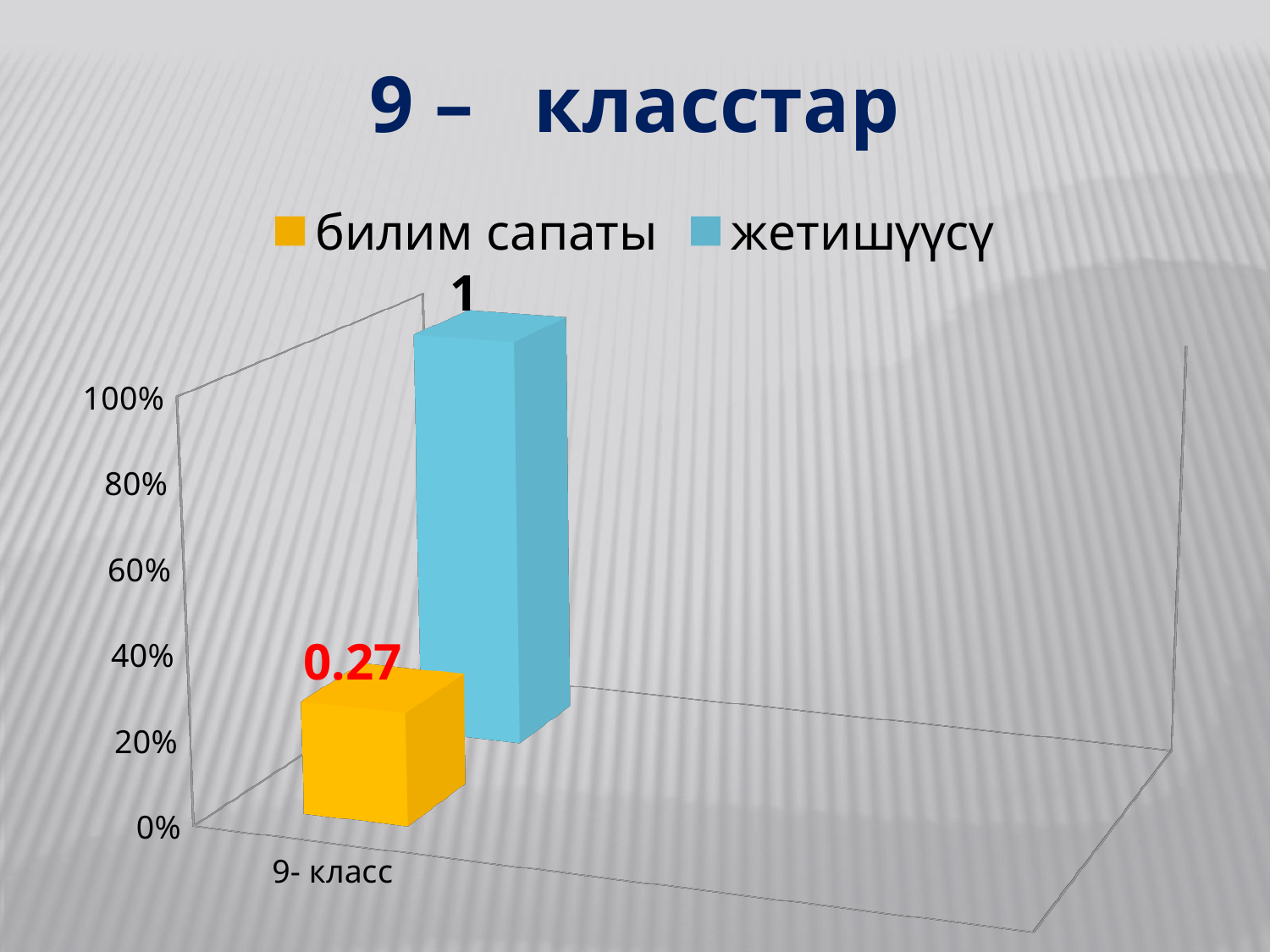
What is the difference between the жетишүүсү value and the билим сапаты value for 9- класс? 0.73 Is the value for жетишүүсү greater or less than 80%? greater How many series does the legend list? 2 What is the value for жетишүүсү for 9- класс? 1 Which series has the highest value on the chart? жетишүүсү What kind of chart is shown on the slide? bar chart What is the value for билим сапаты for 9- класс? 0.27 Which series has the lowest value on the chart? билим сапаты What colour is the bar for билим сапаты? yellow How many categories are shown on the x axis? 1 Which series has the higher value for 9- класс, билим сапаты or жетишүүсү? жетишүүсү Is the value for билим сапаты greater or less than 40%? less